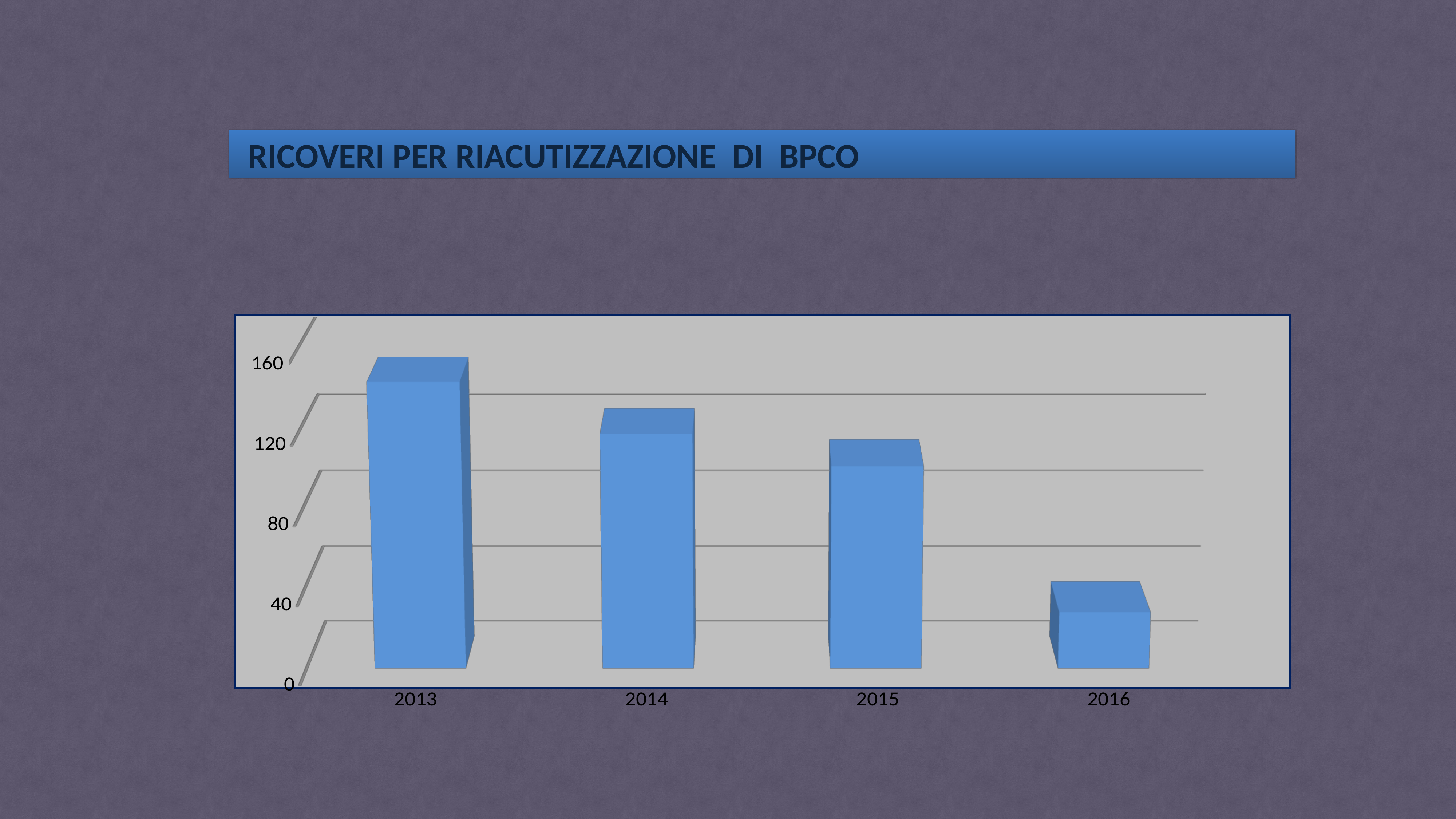
Is the value for 2013 greater or less than 120? greater How many years are shown on the x axis of the chart? 4 Which year has the larger value, 2013 or 2016? 2013 What is the title of the slide? RICOVERI PER RIACUTIZZAZIONE DI BPCO Which year has the lowest number of ricoveri? 2016 Is the value for 2016 greater or less than 80? less Do the values rise or fall from 2013 to 2016? fall Which year has the larger value, 2014 or 2015? 2014 Is the value for 2015 greater or less than 80? greater What is the highest tick value shown on the vertical axis? 160 Which year has the highest number of ricoveri? 2013 What kind of chart is shown on the slide? bar chart